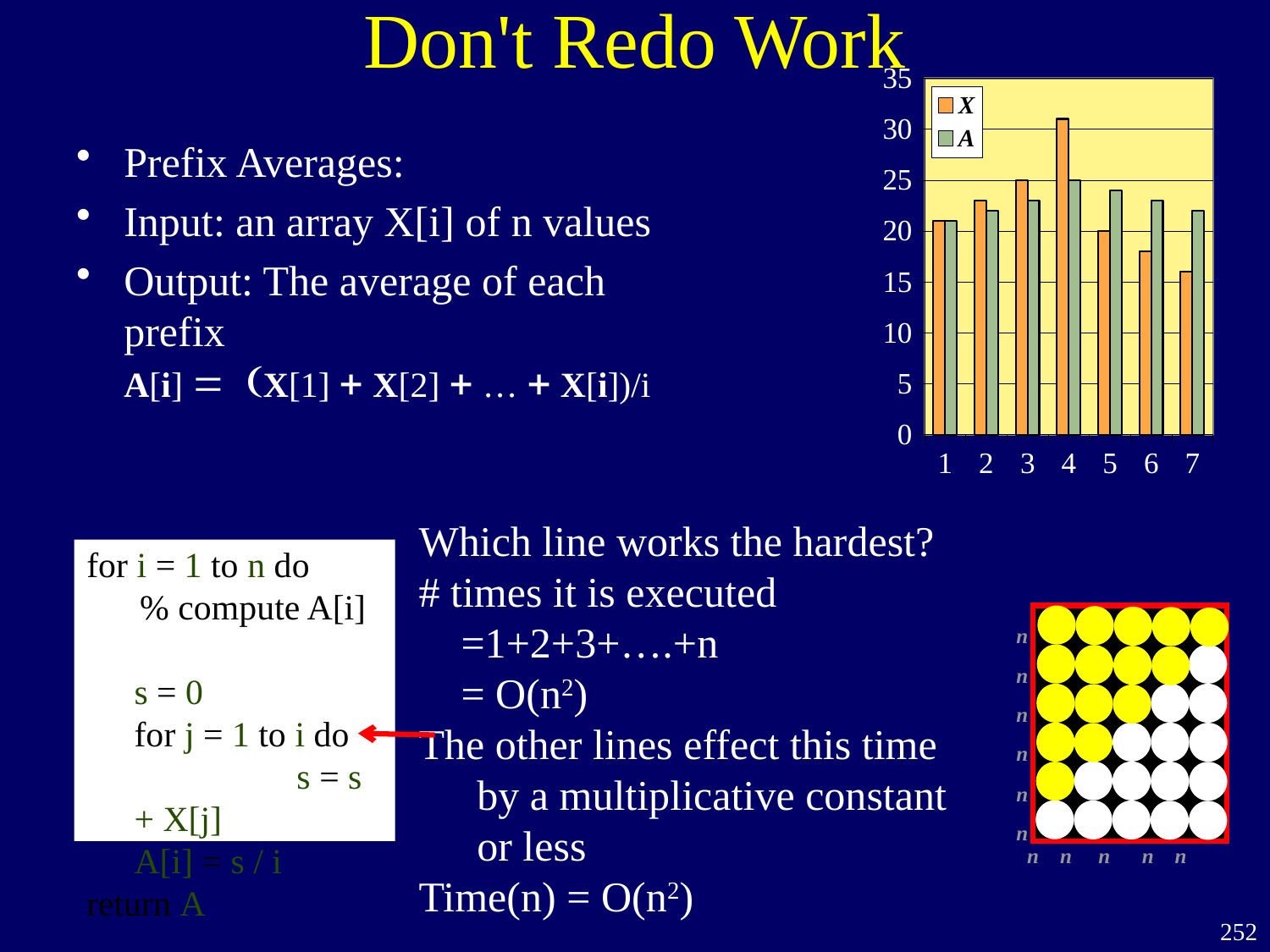
Is the value of series X at category 4 greater or less than 25? greater How many categories are shown along the x axis of the chart? 7 How many series does the chart's legend list? 2 What are the two series names listed in the chart's legend? X and A Is the value of series A at category 4 greater or less than 20? greater Which category has the highest value for series X? 4 What kind of chart is shown on the slide? bar chart At category 4, which series has the larger value, X or A? X Is the value of series X at category 7 greater or less than 20? less Which category has the lowest value for series X? 7 Do the values of series X rise or fall from category 4 to category 7? fall At category 6, which series has the larger value, X or A? A